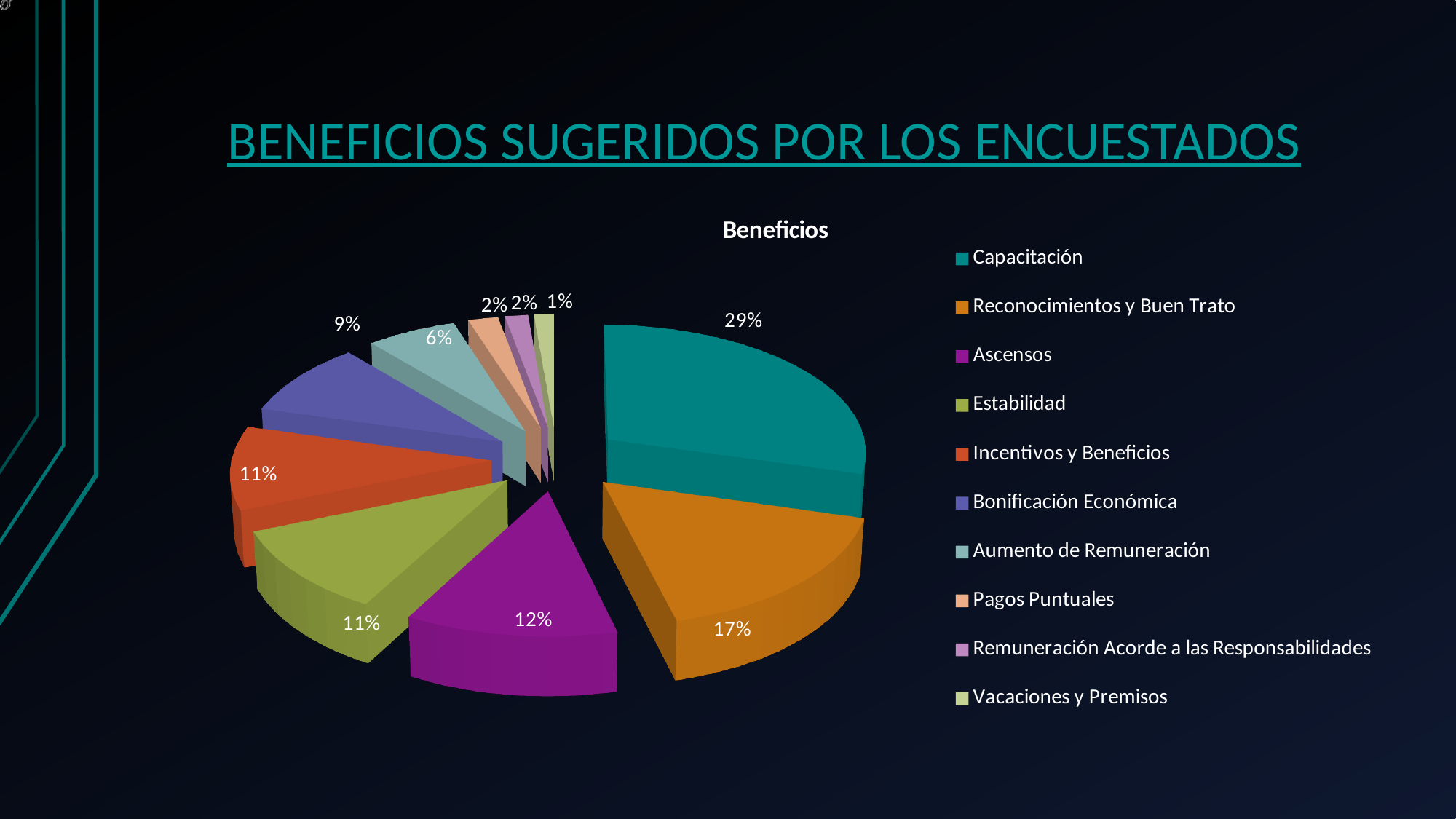
What is the value for Aumento de Remuneración? 6% Which category has the smallest share of the pie? Vacaciones y Premisos Which category has the largest share of the pie? Capacitación What share of the pie does Capacitación represent? 29% What is the difference between the shares of Capacitación and Reconocimientos y Buen Trato? 12% How many categories does the legend list? 10 What kind of chart is shown on the slide? Pie chart What is the value for Ascensos? 12% What is the value for Bonificación Económica? 9% What is the title of the chart? Beneficios What share of the pie does Reconocimientos y Buen Trato represent? 17% Which is larger, the share for Ascensos or the share for Bonificación Económica? Ascensos